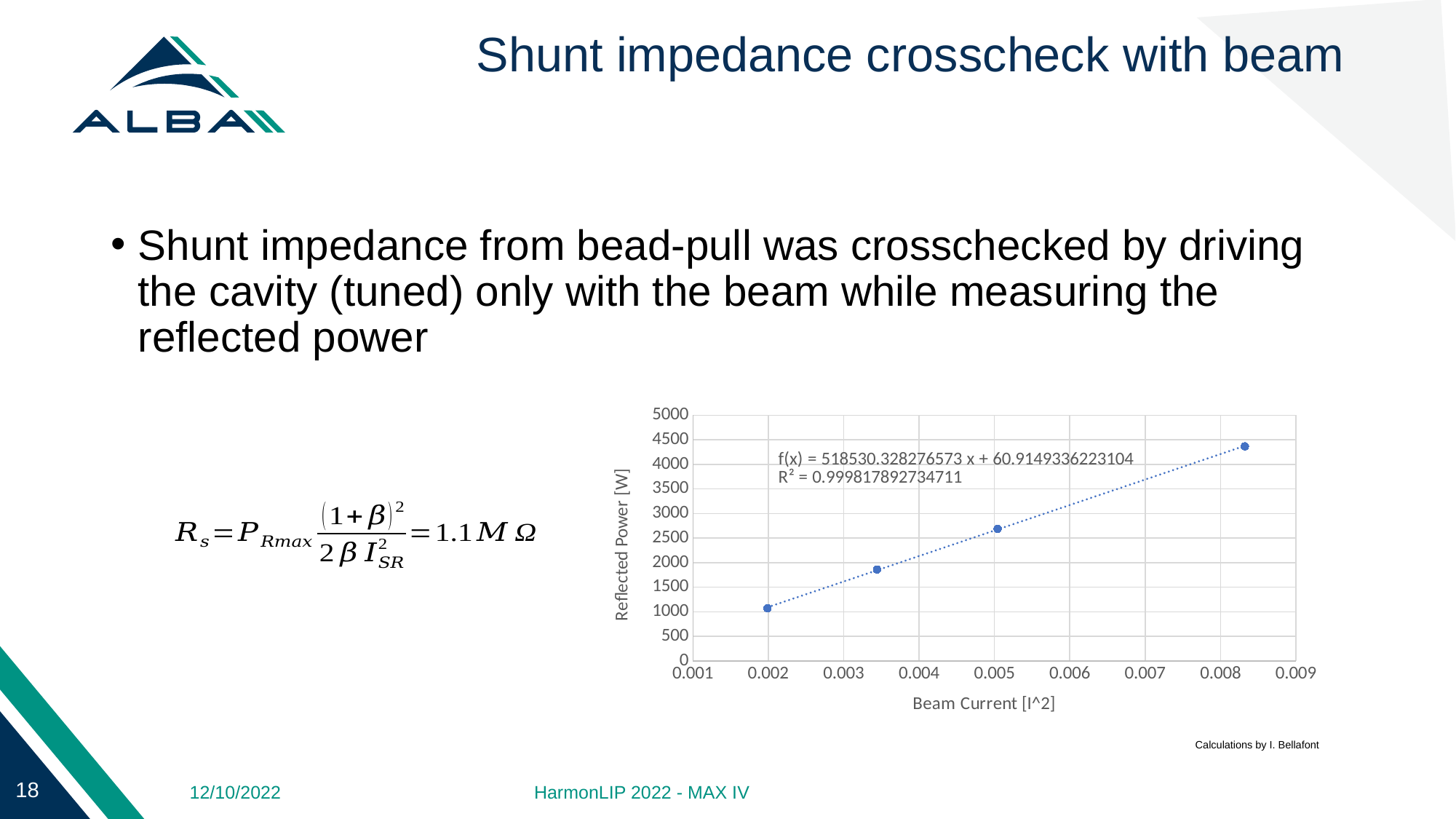
Does the reflected power rise or fall as beam current increases along the x axis? rise Is the reflected power at the point with the smallest beam current greater or less than 1500? less Is the reflected power at the point near a beam current of 0.0035 greater or less than 2000? less What is the label of the y axis? Reflected Power [W] What kind of chart is shown on the slide? scatter plot What is the label of the x axis? Beam Current [I^2] Is the reflected power at the point with the largest beam current greater or less than 4000? greater How many data points are plotted on the chart? 4 What is the trendline equation printed on the chart? f(x) = 518530.328276573 x + 60.9149336223104 Which point has the highest reflected power: the one at the smallest beam current or the one at the largest beam current? the one at the largest beam current